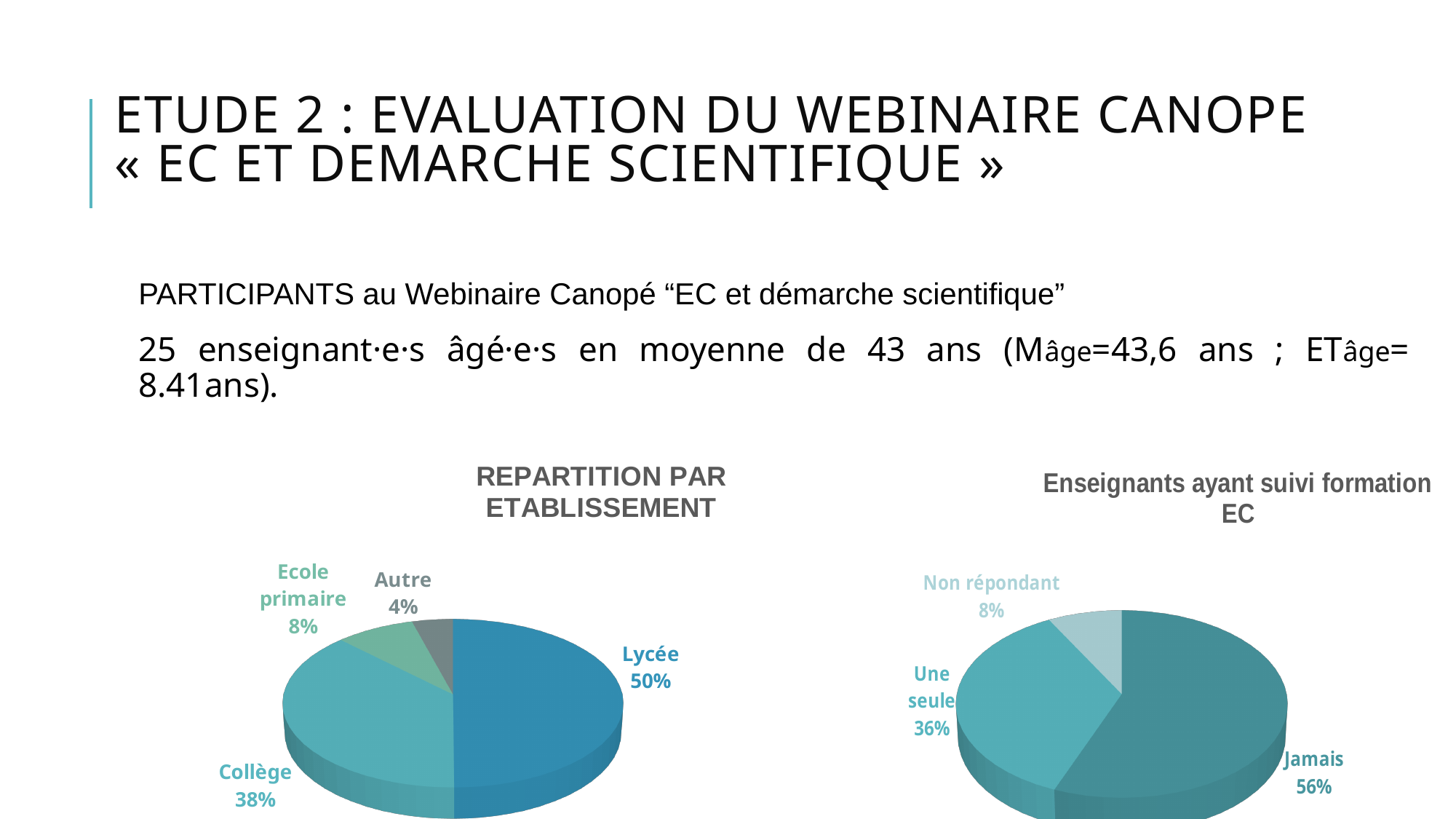
In the 'REPARTITION PAR ETABLISSEMENT' chart, how many categories are shown? 4 In the 'Enseignants ayant suivi formation EC' chart, what is the difference between the Jamais and Une seule shares? 20% In the 'REPARTITION PAR ETABLISSEMENT' chart, what share is Lycée? 50% In the 'REPARTITION PAR ETABLISSEMENT' chart, what share is Collège? 38% In the 'REPARTITION PAR ETABLISSEMENT' chart, which category has the largest share? Lycée In the 'Enseignants ayant suivi formation EC' chart, which is larger, Jamais or Une seule? Jamais In the 'Enseignants ayant suivi formation EC' chart, what share is Jamais? 56% What kind of chart is 'REPARTITION PAR ETABLISSEMENT'? Pie chart In the 'Enseignants ayant suivi formation EC' chart, what share is Non répondant? 8% In the 'Enseignants ayant suivi formation EC' chart, how many categories are shown? 3 In the 'REPARTITION PAR ETABLISSEMENT' chart, which category has the smallest share? Autre In the 'REPARTITION PAR ETABLISSEMENT' chart, what is the difference between the Lycée and Collège shares? 12%